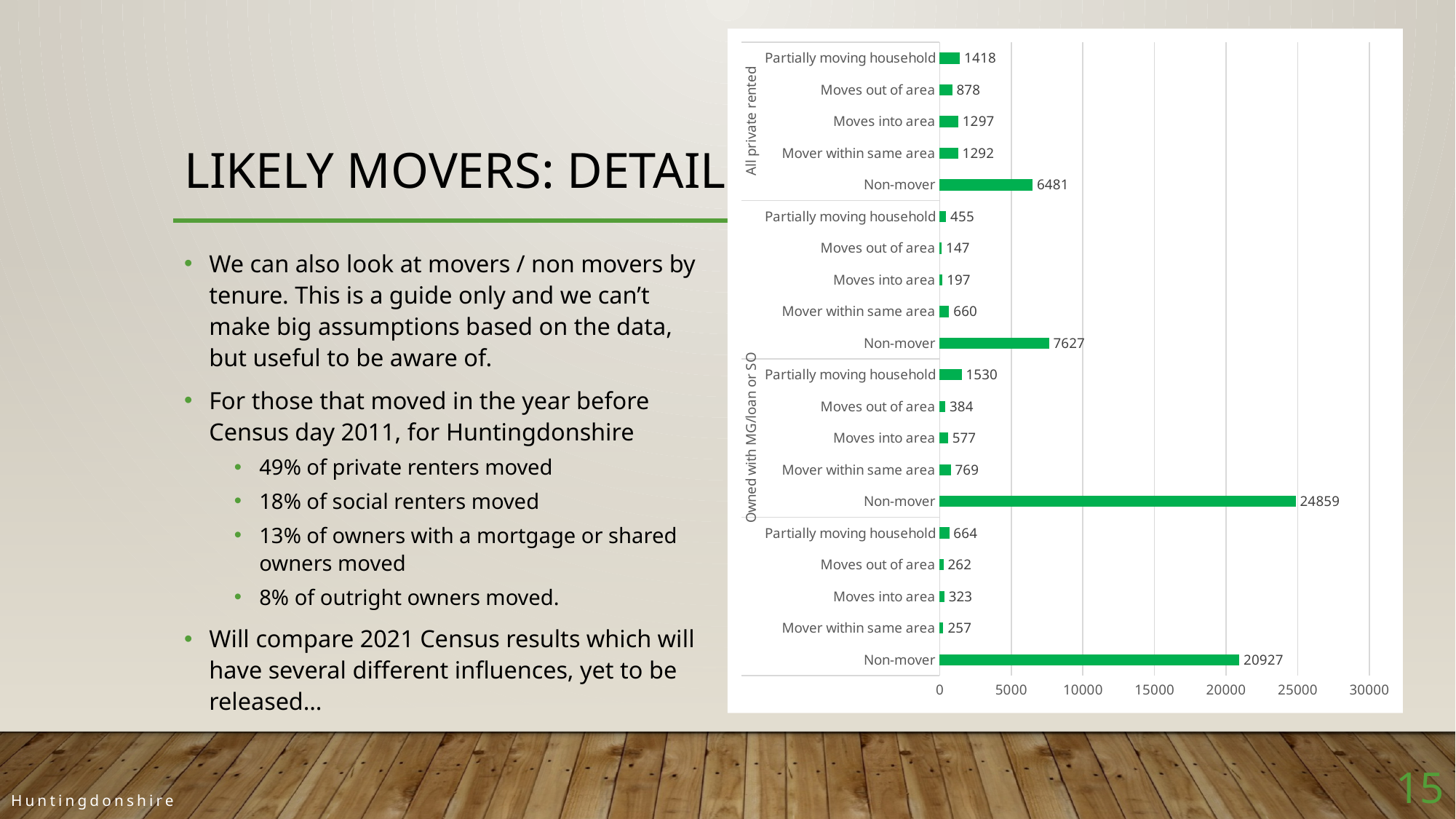
In the All private rented group, what is the difference between Non-mover and Partially moving household? 5063 What is the smallest value shown on the chart? 147 What is the highest value labelled on the horizontal axis? 30000 What type of chart is shown on the slide? bar chart What is the value for Non-mover in the All private rented group? 6481 What is the value for Partially moving household in the Owned with MG/loan or SO group? 1530 Is the value for Non-mover in the Owned with MG/loan or SO group greater or less than 20000? greater What is the value for Non-mover in the Owned with MG/loan or SO group? 24859 How many bars are plotted on the chart in total? 20 Which bar has the highest value on the chart? Non-mover in Owned with MG/loan or SO (24859) In the All private rented group, which is larger: Moves into area or Moves out of area? Moves into area What is the value for Moves out of area in the All private rented group? 878